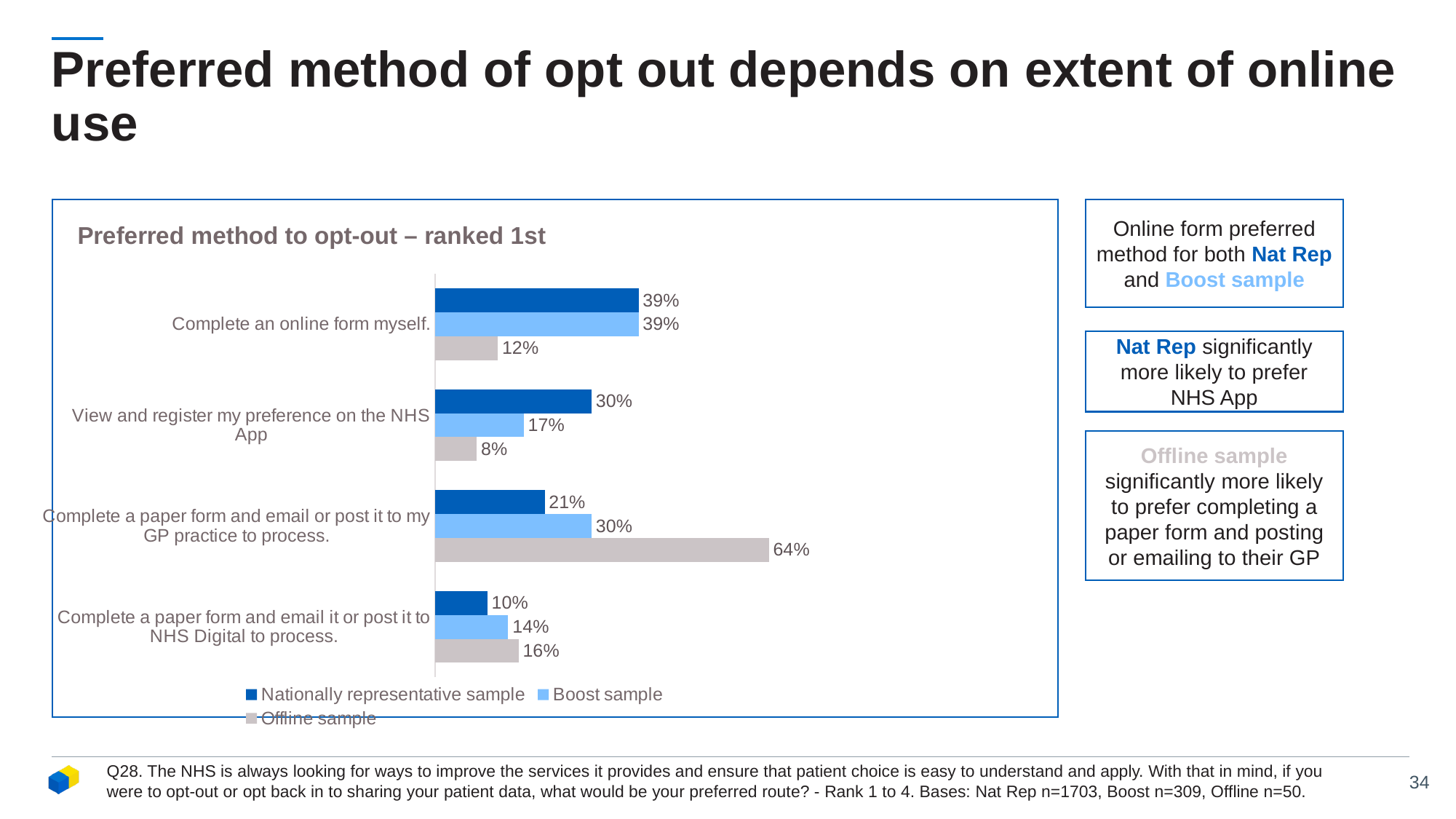
What type of chart is shown on the slide? Bar chart Which category has the lowest value for the Nationally representative sample? Complete a paper form and email it or post it to NHS Digital to process. What percentage of the Nationally representative sample ranked 'Complete an online form myself.' first? 39% What is the difference between the Offline sample and the Nationally representative sample for 'Complete a paper form and email or post it to my GP practice to process.'? 43 percentage points For 'Complete a paper form and email it or post it to NHS Digital to process.', which is larger: the Boost sample or the Offline sample? Offline sample What is the Offline sample value for 'Complete a paper form and email or post it to my GP practice to process.'? 64% How many opt-out methods (categories) are shown in the chart? 4 What is the title of the chart? Preferred method to opt-out – ranked 1st For 'View and register my preference on the NHS App', which is larger: the Nationally representative sample or the Boost sample? Nationally representative sample Which category has the highest value for the Offline sample? Complete a paper form and email or post it to my GP practice to process. What is the Boost sample value for 'View and register my preference on the NHS App'? 17% How many series does the legend list? 3